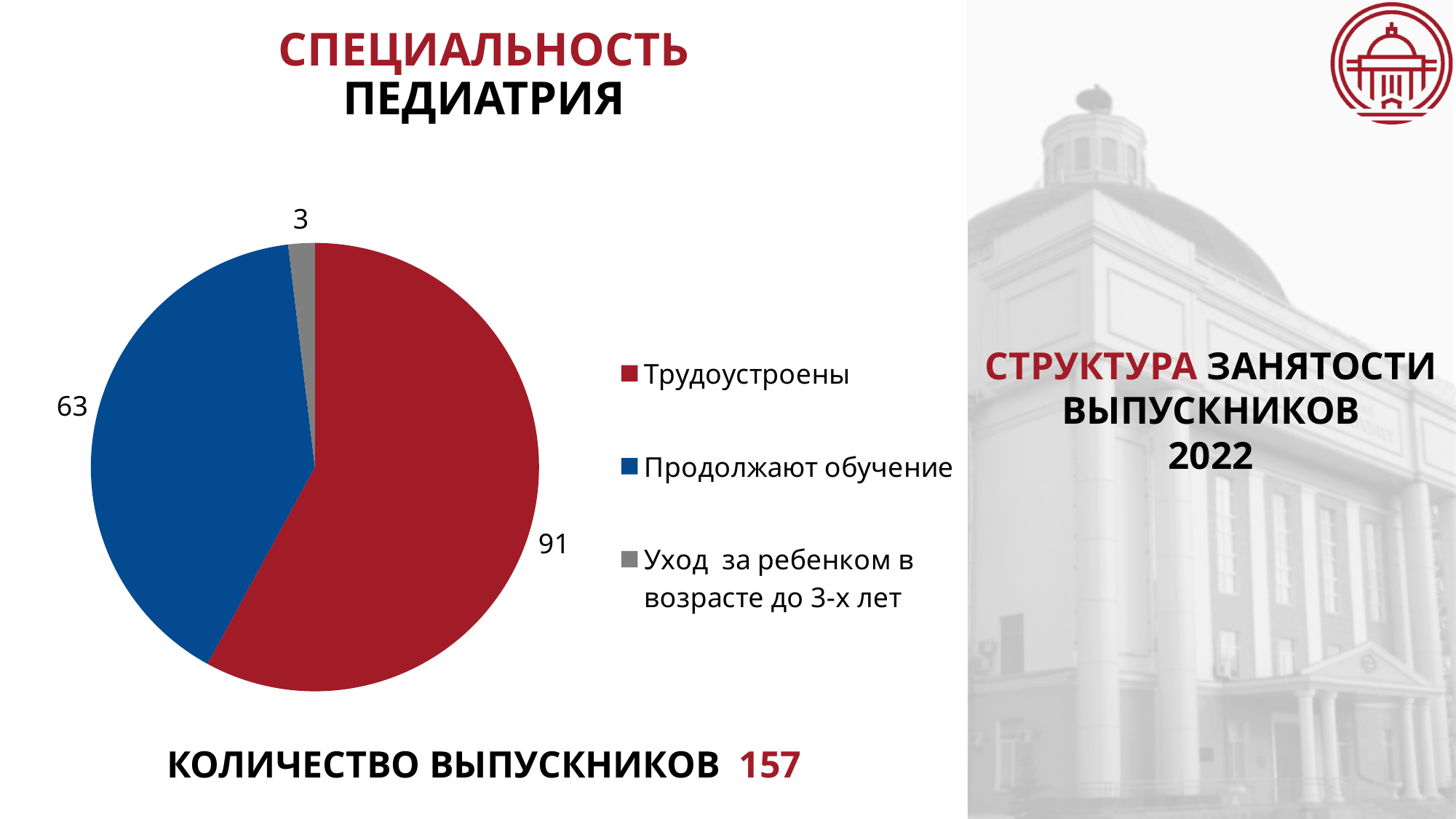
Which category has the largest slice of the pie? Трудоустроены What is the difference between the 'Трудоустроены' and 'Продолжают обучение' values? 28 What is the total of all slices in the pie chart? 157 How many graduates are in the 'Трудоустроены' category? 91 How many categories does the pie chart have? 3 What is the value for 'Продолжают обучение'? 63 What colour is the 'Продолжают обучение' slice? blue What type of chart is shown on the slide? pie chart How many entries does the legend list? 3 Which category has the smallest slice of the pie? Уход за ребенком в возрасте до 3-х лет What is the value for 'Уход за ребенком в возрасте до 3-х лет'? 3 Which is larger: 'Продолжают обучение' or 'Уход за ребенком в возрасте до 3-х лет'? Продолжают обучение